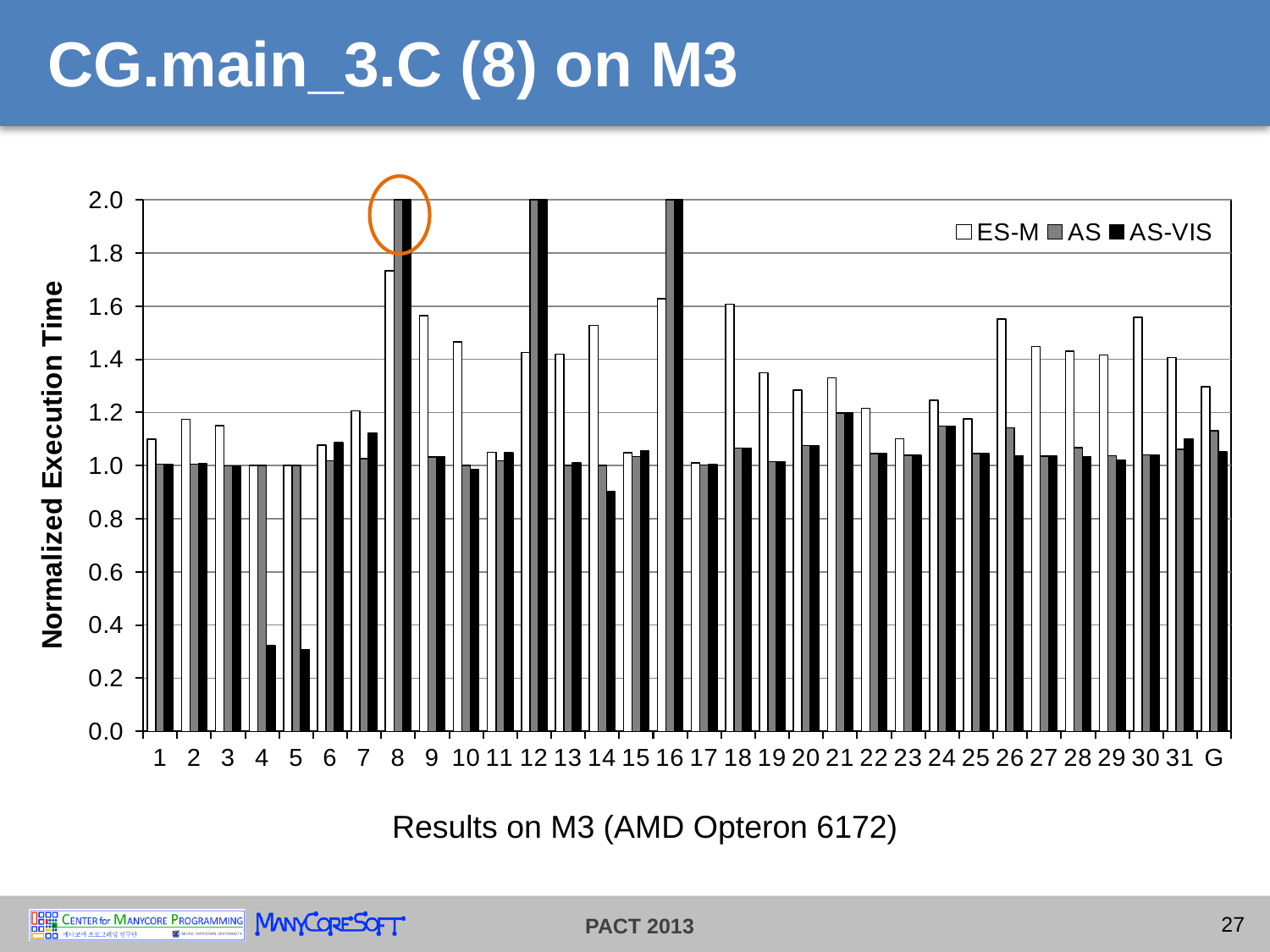
How many series does the legend list? 3 What is the label of the y axis? Normalized Execution Time Is the ES-M value for category 18 greater or less than 1.4? greater For category 14, which is larger: the ES-M value or the AS-VIS value? ES-M How many categories are shown along the x axis? 32 Is the AS-VIS value for category 5 greater or less than 0.4? less What kind of chart is shown on the slide? bar chart Is the AS-VIS value for category 14 greater or less than 1.0? less Which series are listed in the legend? ES-M, AS, AS-VIS For category 8, which is larger: the ES-M value or the AS-VIS value? AS-VIS